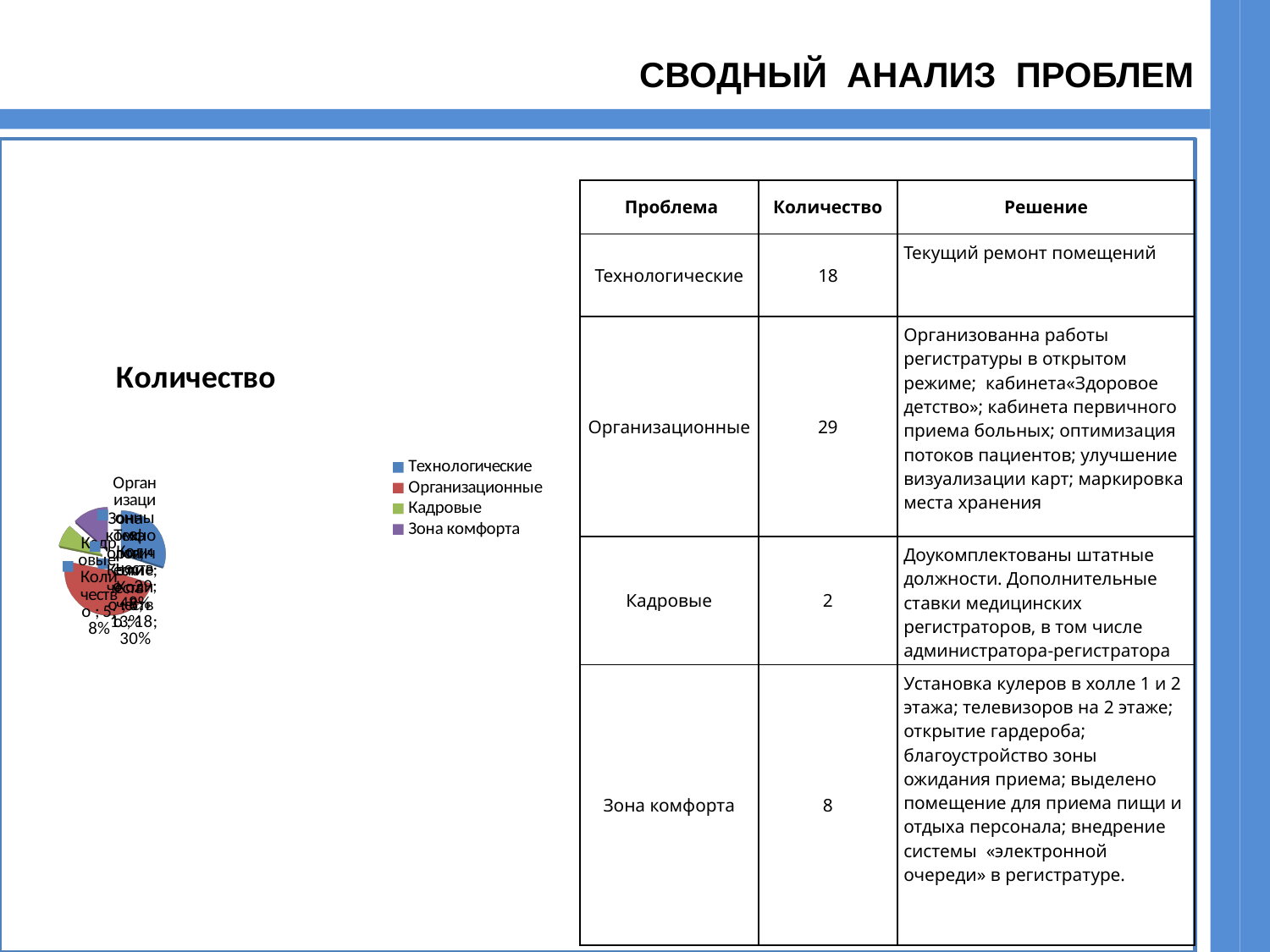
Which category has the smallest slice of the pie? Кадровые What is the value for Технологические? 18 What is the title of the chart? Количество Which colour represents Организационные in the chart's legend? red How many categories does the chart's legend list? 4 What share of the pie does Технологические take? 30% Which is larger, Технологические or Зона комфорта? Технологические What kind of chart is shown on the slide? pie chart What is the difference between the values for Организационные and Технологические? 11 Which category has the largest slice of the pie? Организационные